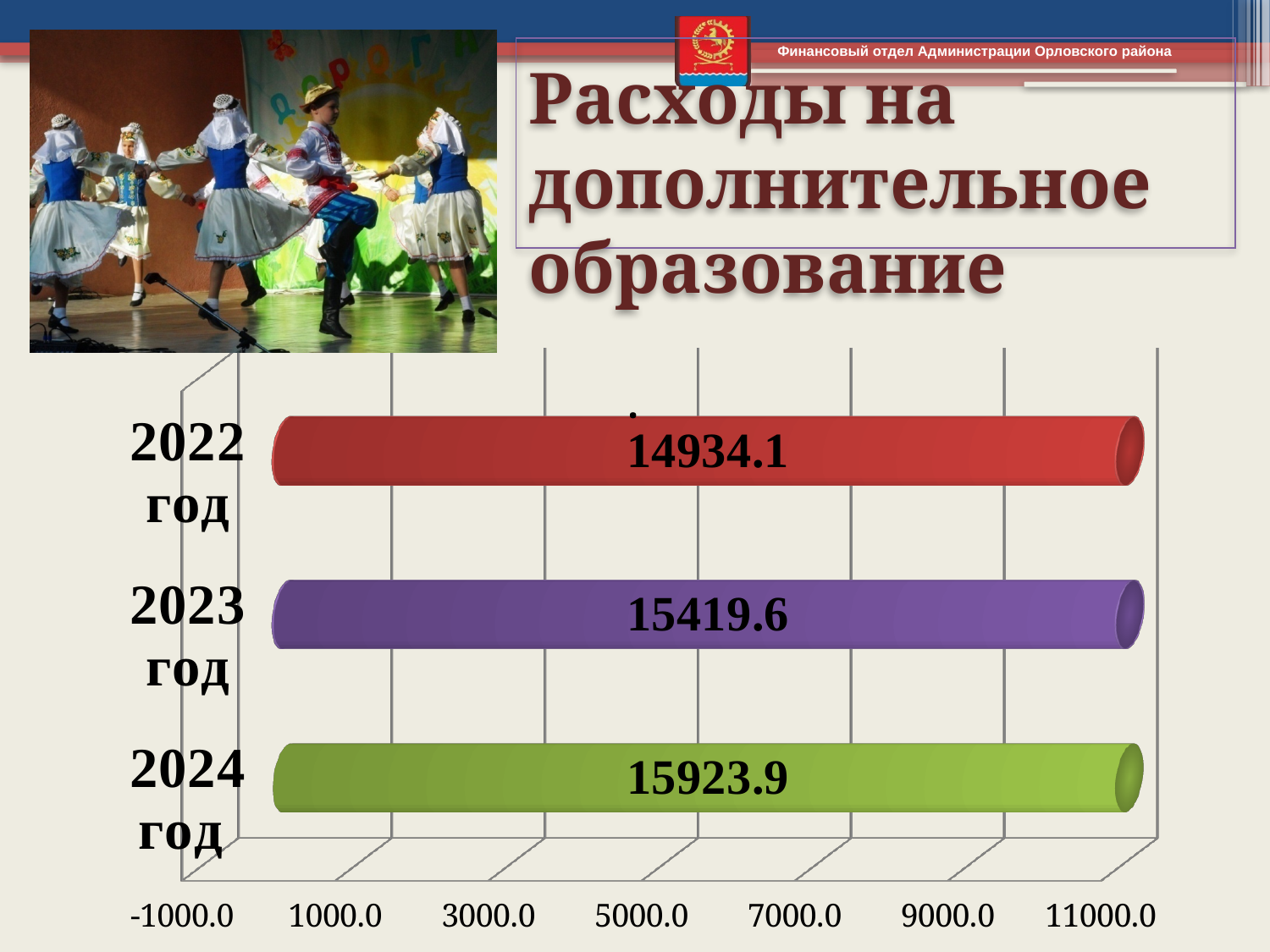
What is the value shown for 2024 год? 15923.9 What is the value shown for 2022 год? 14934.1 What is the difference between the values for 2023 год and 2022 год? 485.5 Do the values rise or fall from 2022 год to 2024 год? Rise What is the difference between the values for 2024 год and 2023 год? 504.3 How many categories (years) are shown in the chart? 3 Which year has the lowest value? 2022 год What is the difference between the values for 2024 год and 2022 год? 989.8 What kind of chart is shown on the slide? Bar chart What is the value shown for 2023 год? 15419.6 Which year has the highest value? 2024 год Which is larger, the value for 2022 год or the value for 2024 год? 2024 год